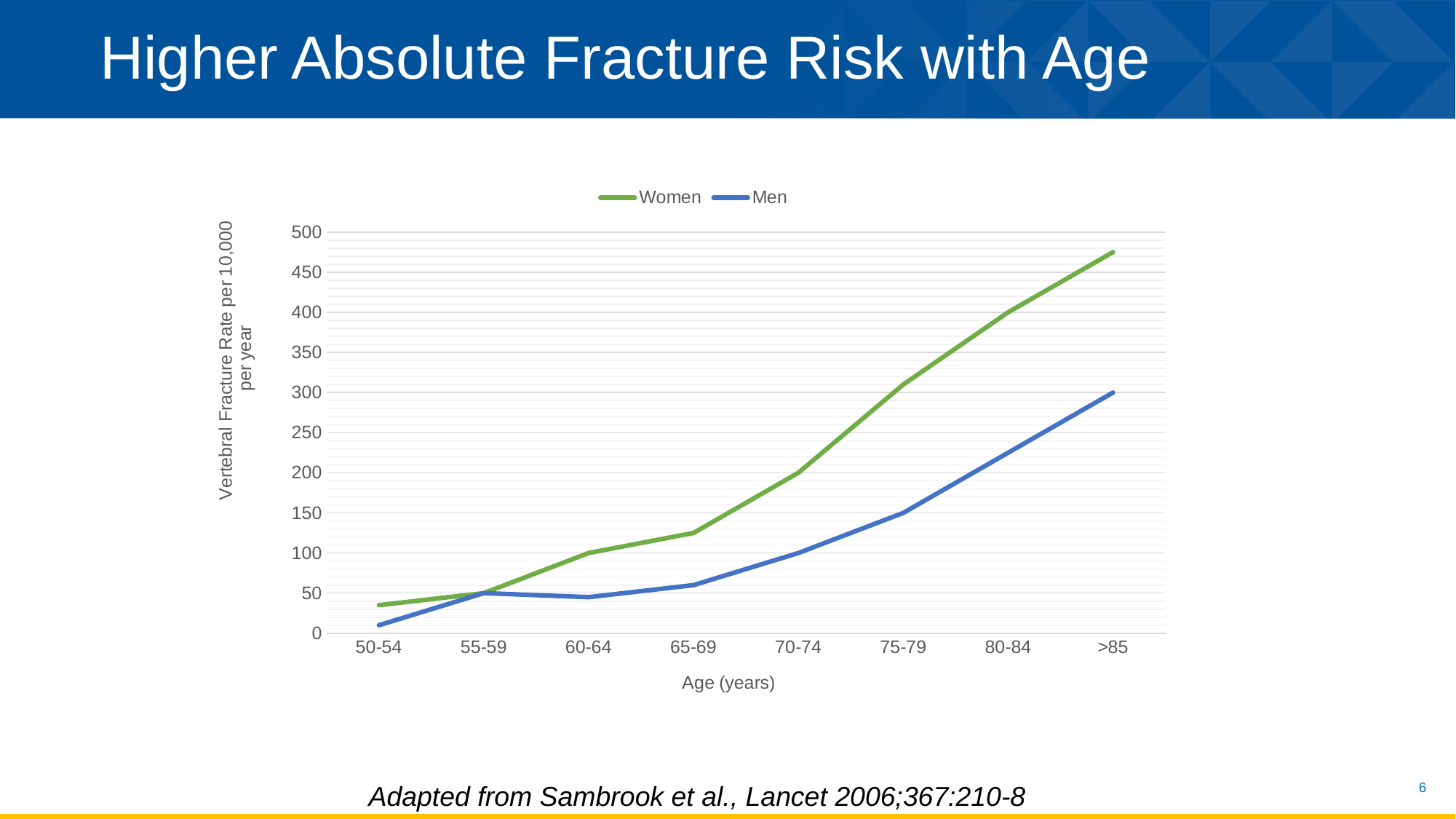
For which age group is the vertebral fracture rate for Men lowest? 50-54 How many series does the legend list? 2 Is the value for Men at age 65-69 greater or less than 100? less Do the vertebral fracture rates for Women rise or fall as age increases along the x axis? rise What kind of chart is shown on the slide? line chart For which age group is the vertebral fracture rate for Women highest? >85 Is the value for Women at age >85 greater or less than 450? greater What is the vertebral fracture rate for Men at age >85? 300 What is the title of the y axis? Vertebral Fracture Rate per 10,000 per year How many age groups are shown on the x axis? 8 At age 80-84, which series has the higher vertebral fracture rate, Women or Men? Women